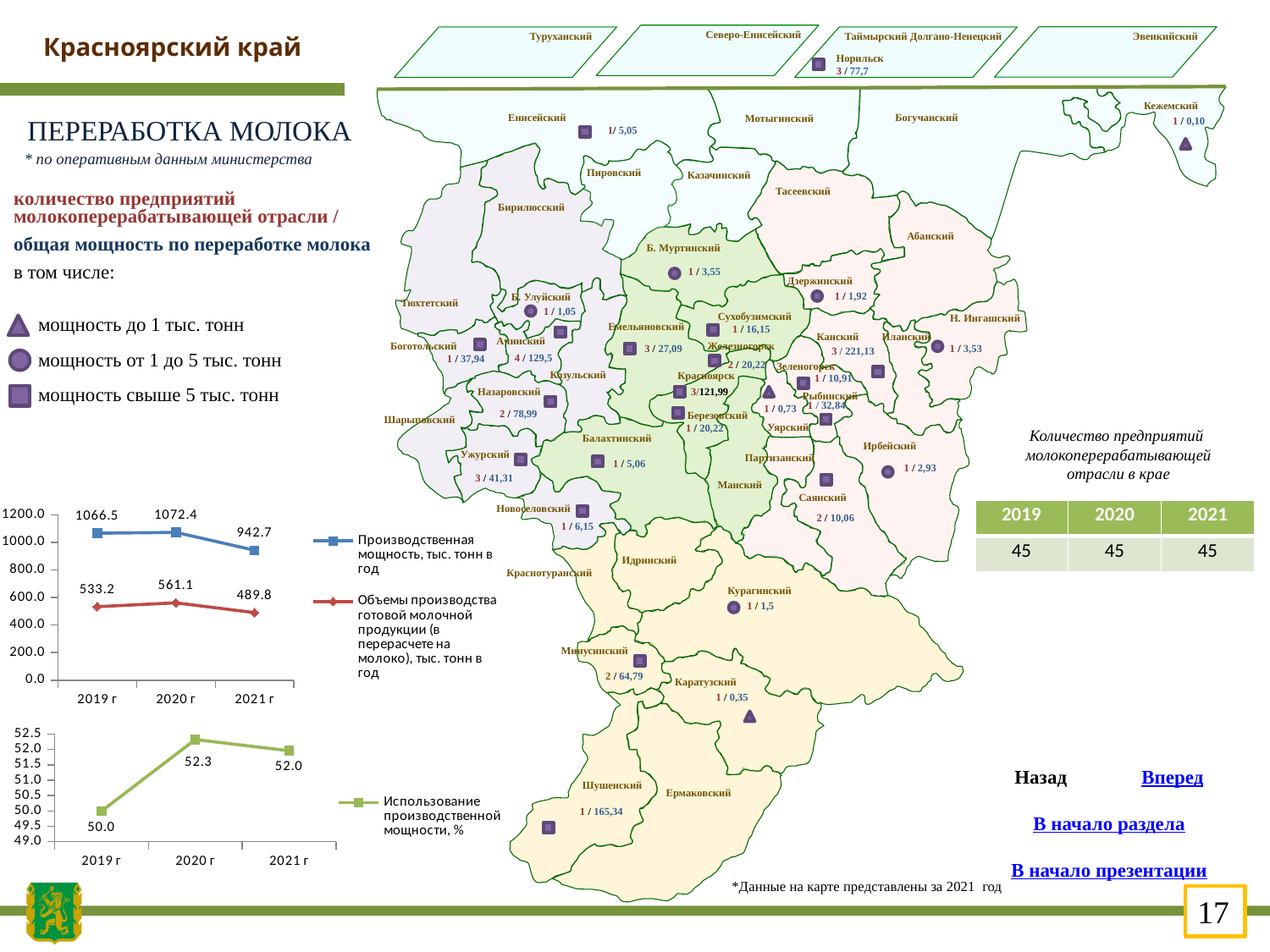
On the upper line chart at the bottom left, does 'Производственная мощность' rise or fall from 2020 г to 2021 г? fall What type of chart is the lower chart at the bottom left of the slide? line chart On the lower line chart at the bottom left, what is the value of 'Использование производственной мощности, %' for 2020 г? 52.3 On the upper line chart at the bottom left, what is the value of 'Производственная мощность, тыс. тонн в год' for 2020 г? 1072.4 On the upper line chart at the bottom left, in which year is 'Объемы производства готовой молочной продукции' lowest? 2021 г On the upper line chart at the bottom left, how many series does the legend list? 2 On the upper line chart at the bottom left, what is the value of 'Объемы производства готовой молочной продукции' for 2021 г? 489.8 On the upper line chart at the bottom left, in which year is 'Производственная мощность' highest? 2020 г On the lower line chart at the bottom left, how many data points are plotted? 3 On the lower line chart at the bottom left, what is the value for 2019 г? 50.0 On the lower line chart at the bottom left, which is larger: the value for 2020 г or 2021 г? 2020 г On the upper line chart at the bottom left, what is the difference between 'Производственная мощность' in 2019 г and 2021 г? 123.8